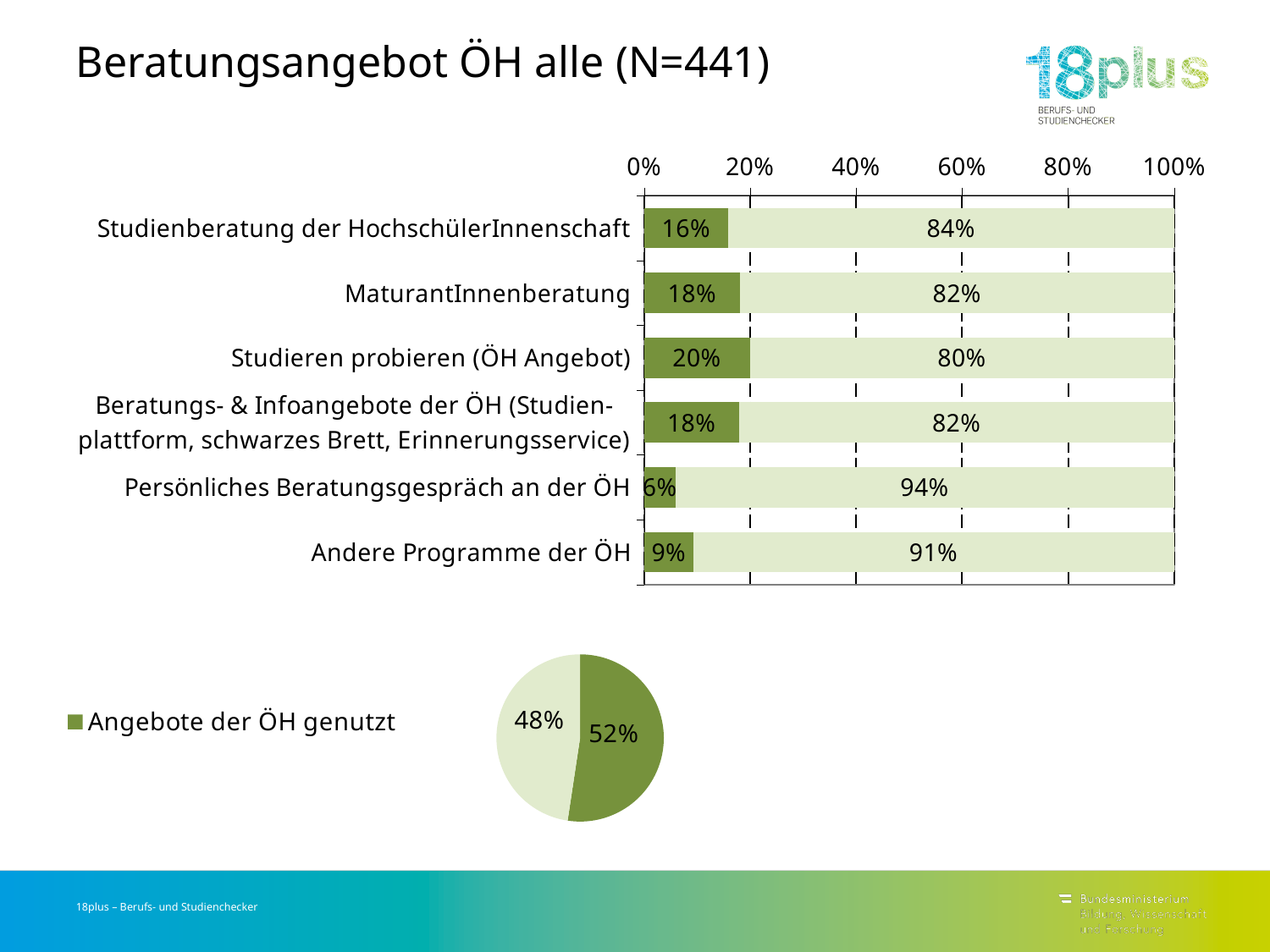
How many categories does the bar chart show? 6 In the pie chart, what share does the light green slice have? 48% In the bar chart, what is the difference between the dark green values for Studieren probieren (ÖH Angebot) and Andere Programme der ÖH? 11% What is the legend entry shown next to the pie chart? Angebote der ÖH genutzt In the bar chart, which category has the highest dark green value? Studieren probieren (ÖH Angebot) What type of chart is the top chart on the slide? Bar chart In the bar chart, what is the light green value for Persönliches Beratungsgespräch an der ÖH? 94% In the bar chart, which category has the lowest dark green value? Persönliches Beratungsgespräch an der ÖH In the bar chart, which has the larger dark green value: Studienberatung der HochschülerInnenschaft or Andere Programme der ÖH? Studienberatung der HochschülerInnenschaft In the bar chart, what is the dark green value for Studieren probieren (ÖH Angebot)? 20% In the bar chart, what is the dark green value for MaturantInnenberatung? 18% In the pie chart, what share does the dark green slice have? 52%